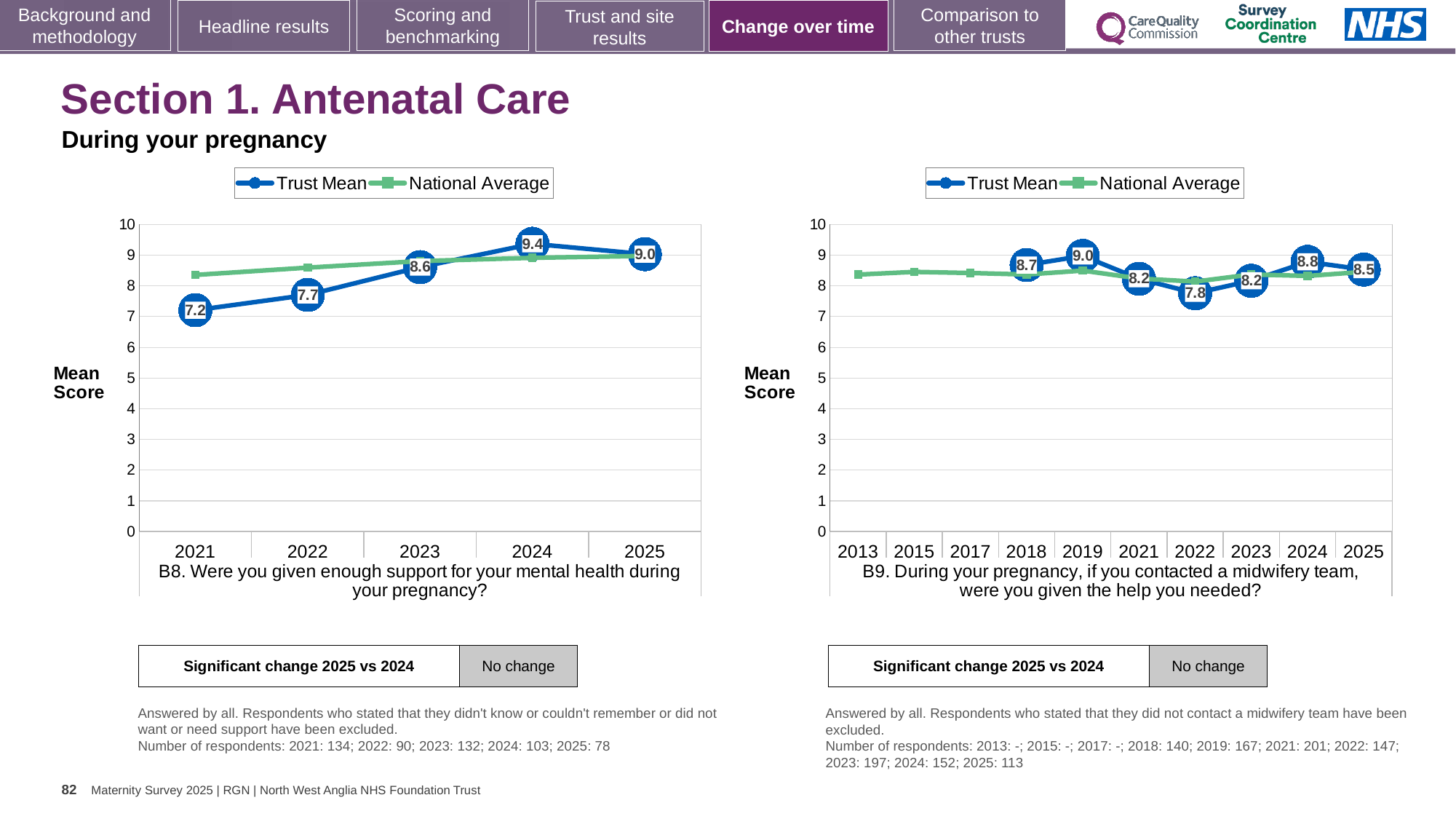
In the B8 chart (left), what is the difference between the Trust Mean for 2024 and 2021? 2.2 In the B8 chart (left), what is the Trust Mean for 2024? 9.4 In the B9 chart (right), which year has the highest Trust Mean? 2019 In the B9 chart (right), which is larger, the Trust Mean for 2024 or for 2025? 2024 In the B9 chart (right), what is the Trust Mean for 2022? 7.8 In the B8 chart (left), how many series does the legend list? 2 In the B8 chart (left), which year has the lowest Trust Mean? 2021 In the B8 chart (left), what is the Trust Mean for 2021? 7.2 In the B8 chart (left), which year has the highest Trust Mean? 2024 What type of chart is the B8 chart (left)? Line chart In the B9 chart (right), is the National Average for 2013 greater or less than 7? greater In the B9 chart (right), how many years are shown on the x axis? 10